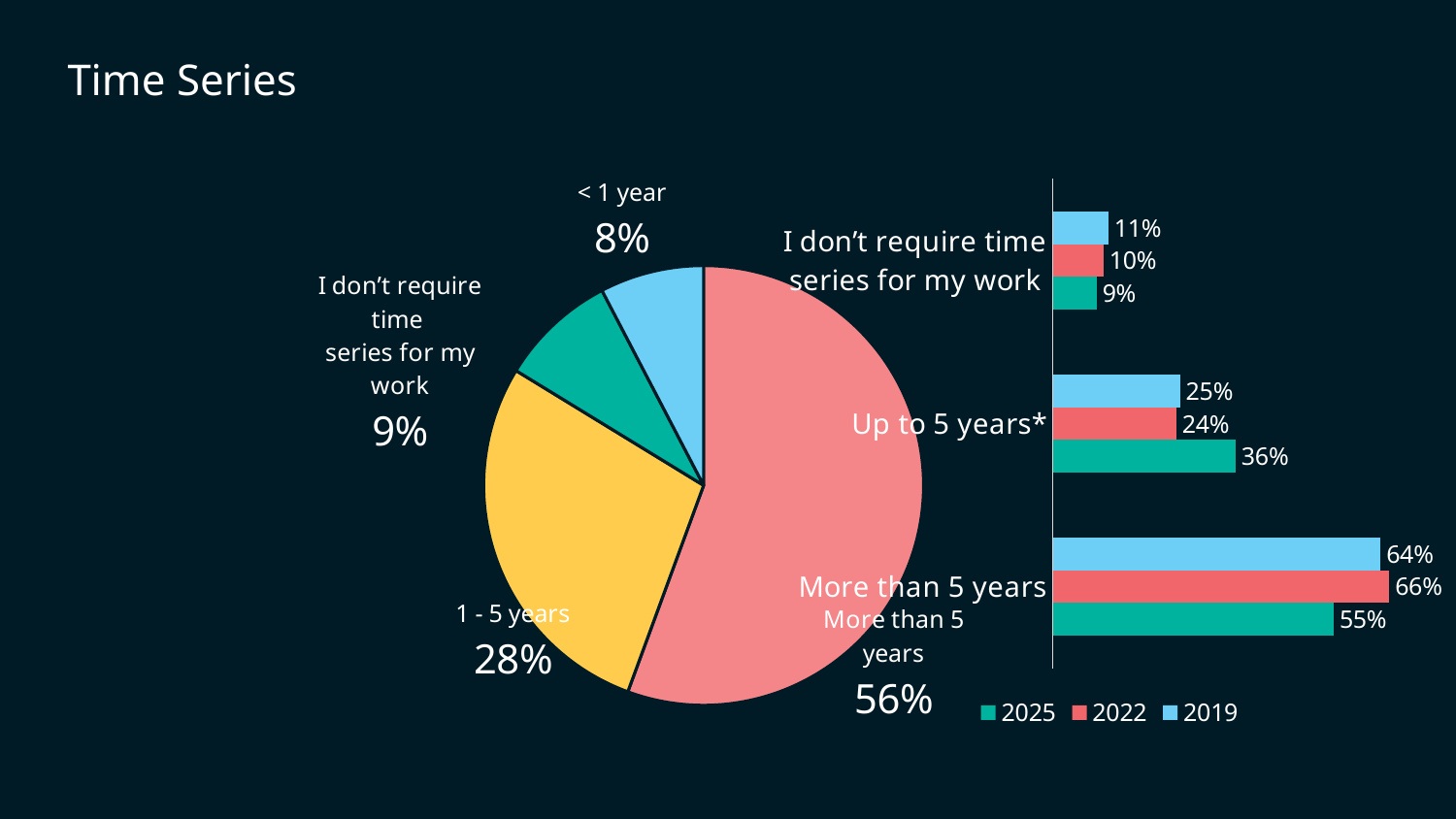
In the bar chart on the right, which series has the highest value for 'More than 5 years'? 2022 In the bar chart on the right, what is the 2019 value for 'I don't require time series for my work'? 11% In the bar chart on the right, how many series does the legend list? 3 In the pie chart on the left, what share is labelled for 'More than 5 years'? 56% In the pie chart on the left, what share is labelled for '1 - 5 years'? 28% In the pie chart on the left, how many slices are there? 4 What kind of chart is shown on the right side of the slide? Bar chart In the bar chart on the right, what is the 2025 value for 'Up to 5 years*'? 36% In the bar chart on the right, what is the 2022 value for 'More than 5 years'? 66% In the bar chart on the right, what is the difference between the 2025 and 2022 values for 'Up to 5 years*'? 12% In the pie chart on the left, which category has the smallest slice? < 1 year In the pie chart on the left, what is the difference between the 'More than 5 years' share and the '1 - 5 years' share? 28%